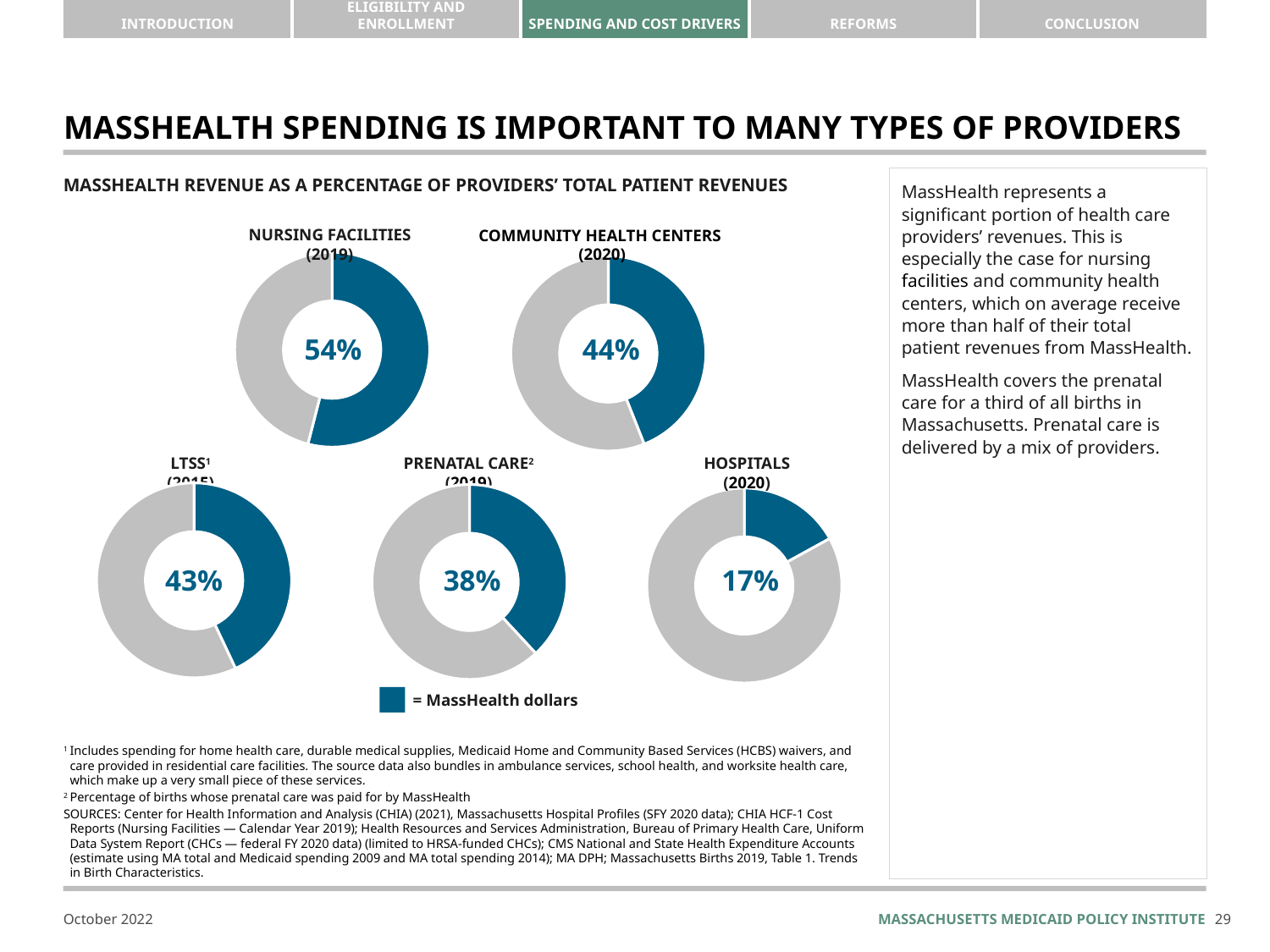
According to the legend, what does the dark blue segment in each donut chart represent? MassHealth dollars Across the five donut charts, which provider type has the lowest MassHealth share of revenue? Hospitals Which is larger: the MassHealth share for Community Health Centers (2020) or for Prenatal Care (2019)? Community Health Centers (2020) What value is shown in the LTSS (2015) donut chart? 43% What value is shown in the Hospitals (2020) donut chart? 17% How many donut charts are shown on the slide? 5 What percentage of nursing facilities' total patient revenues comes from MassHealth, according to the Nursing Facilities (2019) donut chart? 54% Across the five donut charts, which provider type has the highest MassHealth share of revenue? Nursing Facilities In the Community Health Centers (2020) donut chart, what share of revenue is MassHealth dollars? 44% What type of chart is used to show MassHealth revenue as a percentage of providers' total patient revenues? Donut (pie) chart What is the difference in percentage points between the Nursing Facilities (2019) value and the Hospitals (2020) value? 37 percentage points What percentage is shown in the Prenatal Care (2019) donut chart? 38%